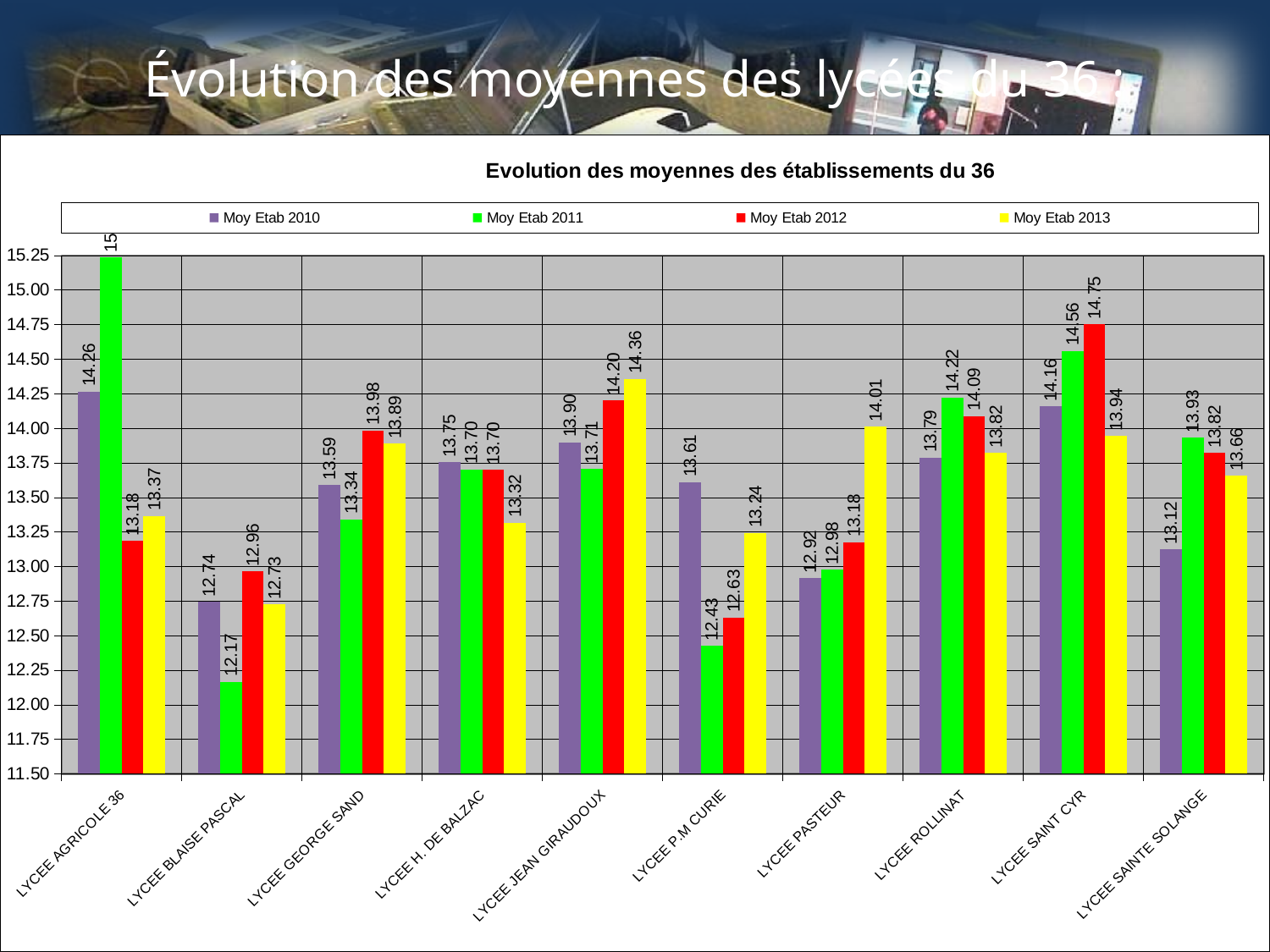
For LYCEE P.M CURIE, which is larger: the Moy Etab 2010 value or the Moy Etab 2011 value? Moy Etab 2010 What colour represents the Moy Etab 2012 series? Red What is the Moy Etab 2011 value for LYCEE AGRICOLE 36? 15 Which lycée has the lowest Moy Etab 2011 value? LYCEE BLAISE PASCAL Which lycée has the highest Moy Etab 2013 value? LYCEE JEAN GIRAUDOUX What type of chart is shown on the slide? Bar chart What is the difference between the Moy Etab 2013 and Moy Etab 2010 values for LYCEE PASTEUR? 1.09 Do the values for LYCEE PASTEUR rise or fall from Moy Etab 2010 to Moy Etab 2013? Rise What is the Moy Etab 2013 value for LYCEE PASTEUR? 14.01 How many series does the legend list? 4 What is the Moy Etab 2012 value for LYCEE SAINT CYR? 14.75 How many lycées (categories) are shown on the x axis? 10